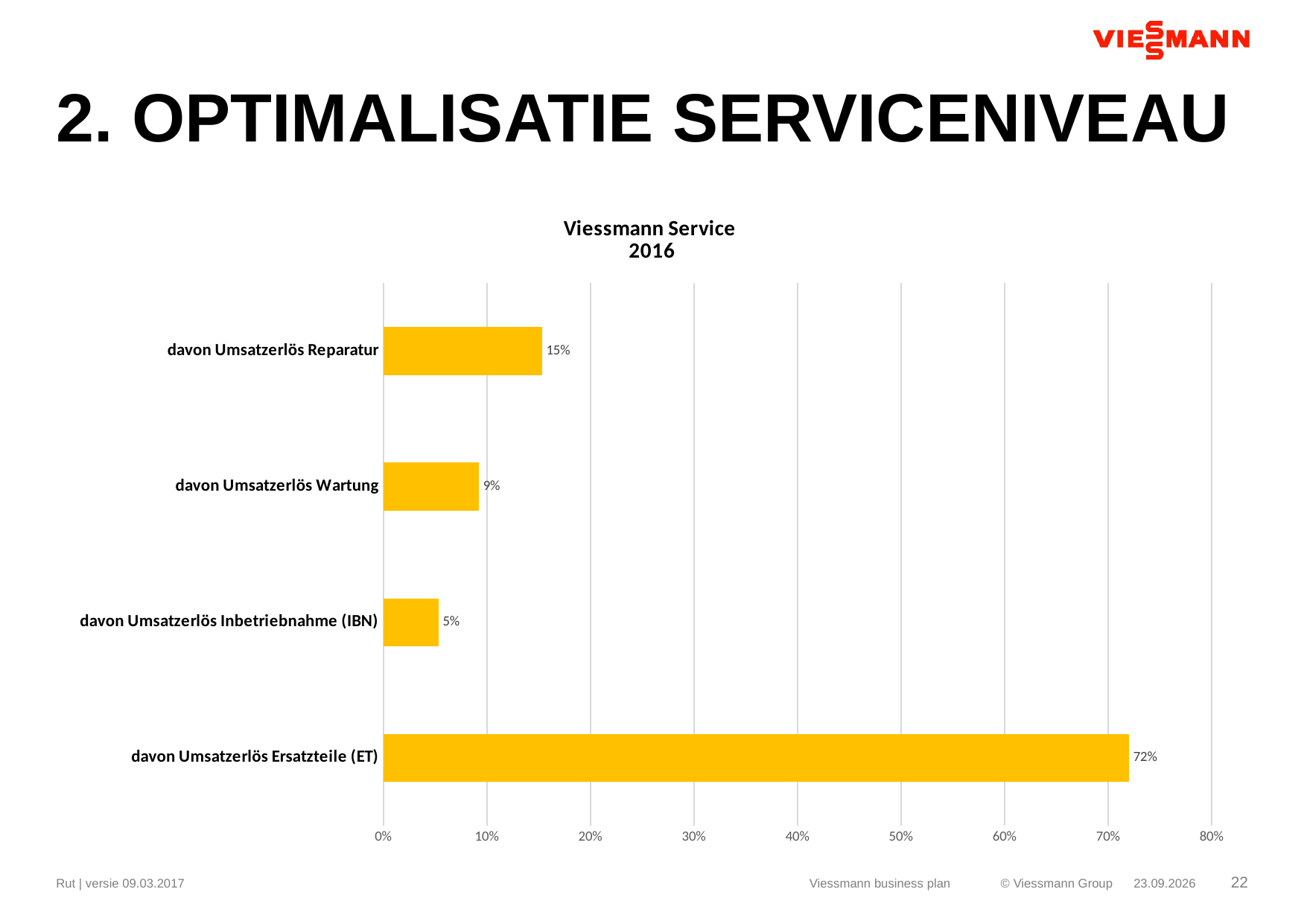
What is the value for davon Umsatzerlös Inbetriebnahme (IBN)? 5% What kind of chart is shown on the slide? bar chart Which is larger, the value for davon Umsatzerlös Reparatur or davon Umsatzerlös Wartung? davon Umsatzerlös Reparatur What is the value for davon Umsatzerlös Wartung? 9% What is the value for davon Umsatzerlös Ersatzteile (ET)? 72% Which category has the lowest value? davon Umsatzerlös Inbetriebnahme (IBN) Is the value for davon Umsatzerlös Ersatzteile (ET) greater or less than 70%? greater How many categories are shown in the chart? 4 What is the difference between the values for davon Umsatzerlös Ersatzteile (ET) and davon Umsatzerlös Reparatur? 57% What is the value for davon Umsatzerlös Reparatur? 15% What is the title of the chart? Viessmann Service 2016 Which category has the highest value? davon Umsatzerlös Ersatzteile (ET)